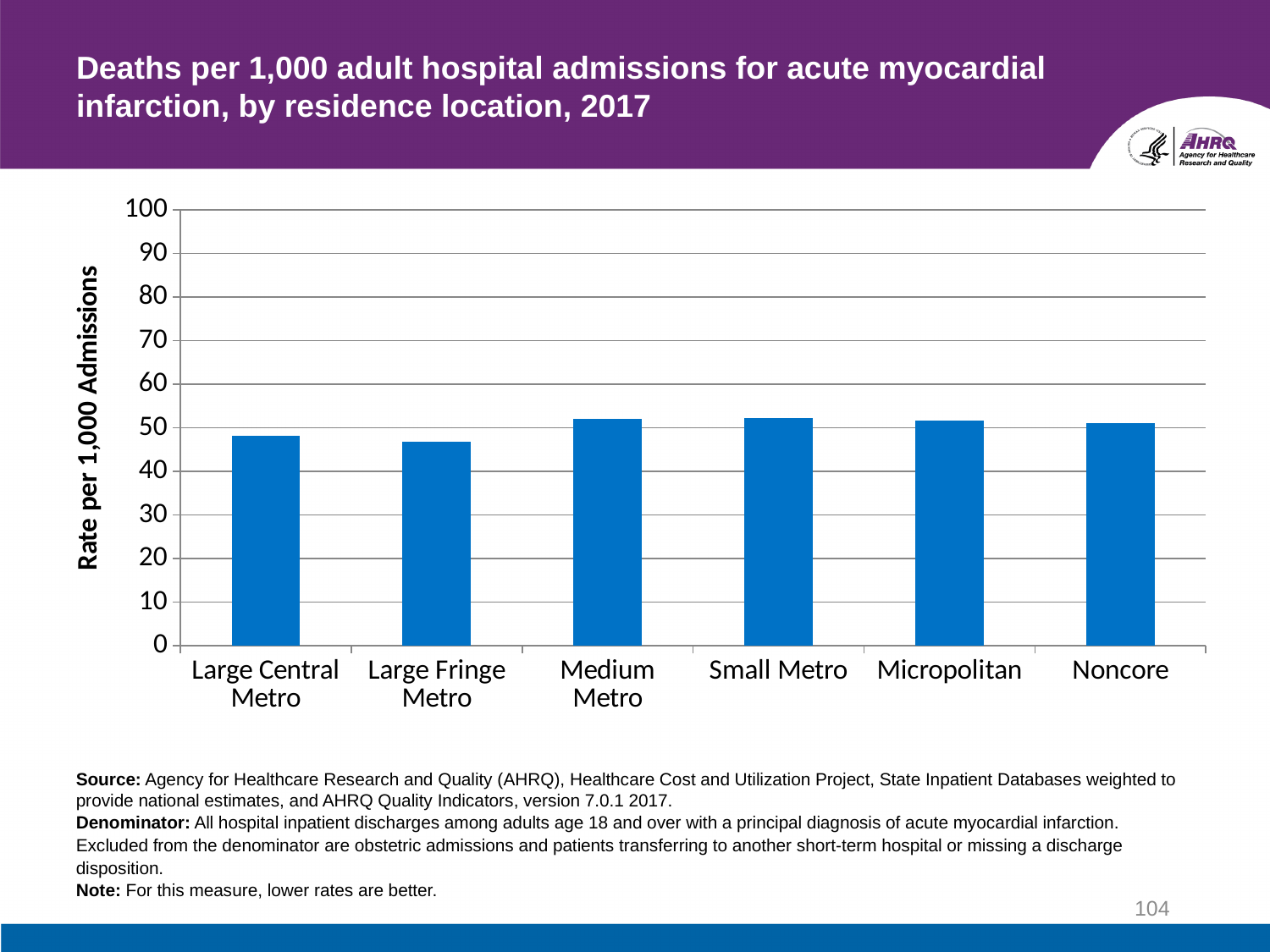
Is the value for Micropolitan greater or less than 60? less Is the value for Noncore greater or less than 40? greater What kind of chart is shown on the slide? bar chart Is the value for Large Central Metro greater or less than 50? less Which has a higher rate, Small Metro or Large Central Metro? Small Metro How many residence location categories are shown on the x axis? 6 What is the label on the y axis of the chart? Rate per 1,000 Admissions What year of data does the chart title say is shown? 2017 Which has a higher rate, Medium Metro or Large Fringe Metro? Medium Metro